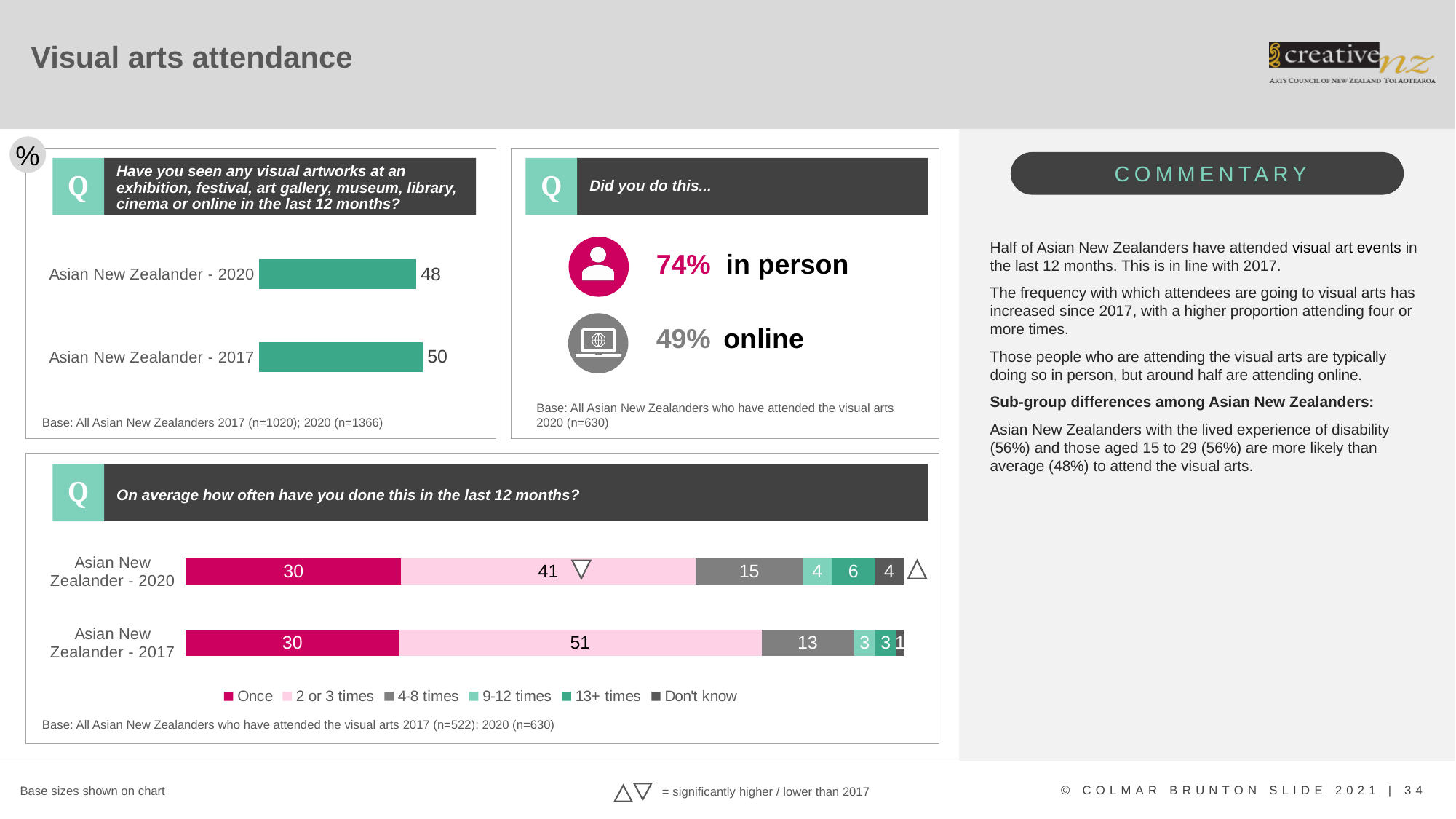
How many series does the legend list in the chart 'On average how often have you done this in the last 12 months?' 6 In the chart 'Have you seen any visual artworks at an exhibition, festival, art gallery, museum, library, cinema or online in the last 12 months?', what is the difference between the 2017 and 2020 values? 2 In the chart 'On average how often have you done this in the last 12 months?', what is the value for '2 or 3 times' for Asian New Zealander - 2017? 51 In the chart 'Have you seen any visual artworks at an exhibition, festival, art gallery, museum, library, cinema or online in the last 12 months?', what is the value for Asian New Zealander - 2017? 50 In the chart 'On average how often have you done this in the last 12 months?', what is the total of the Asian New Zealander - 2020 stacked bar? 100 In the chart 'On average how often have you done this in the last 12 months?', what is the difference between the '2 or 3 times' values for 2017 and 2020? 10 In the chart 'Have you seen any visual artworks at an exhibition, festival, art gallery, museum, library, cinema or online in the last 12 months?', what is the value for Asian New Zealander - 2020? 48 In the chart 'On average how often have you done this in the last 12 months?', which frequency category has the largest value for Asian New Zealander - 2020? 2 or 3 times How many categories are shown in the chart 'Have you seen any visual artworks at an exhibition, festival, art gallery, museum, library, cinema or online in the last 12 months?' 2 In the chart 'On average how often have you done this in the last 12 months?', what is the value for '2 or 3 times' for Asian New Zealander - 2020? 41 What type of chart is used for 'Have you seen any visual artworks at an exhibition, festival, art gallery, museum, library, cinema or online in the last 12 months?' bar chart In the chart 'Have you seen any visual artworks at an exhibition, festival, art gallery, museum, library, cinema or online in the last 12 months?', which category has the higher value? Asian New Zealander - 2017